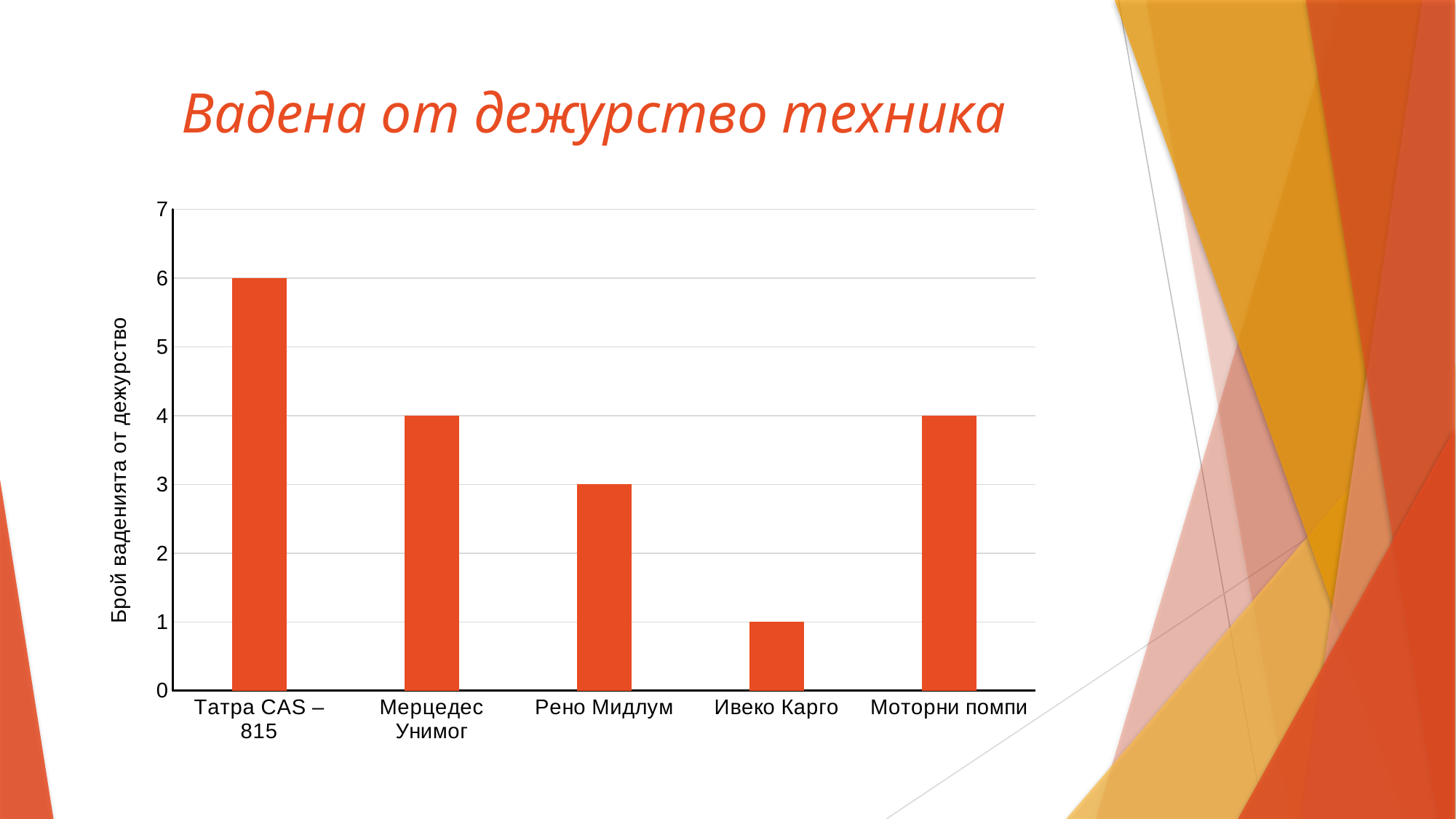
What is the difference between the values for Татра CAS – 815 and Ивеко Карго? 5 What is the value for Татра CAS – 815? 6 Which category has the lowest value? Ивеко Карго What is the title of the vertical axis? Брой ваденията от дежурство How many categories are shown on the x axis? 5 Which is larger, the value for Рено Мидлум or the value for Моторни помпи? Моторни помпи What is the value for Ивеко Карго? 1 What is the value for Моторни помпи? 4 Which category has the highest value? Татра CAS – 815 What kind of chart is shown on the slide? Bar chart What is the difference between the values for Мерцедес Унимог and Рено Мидлум? 1 What is the value for Рено Мидлум? 3